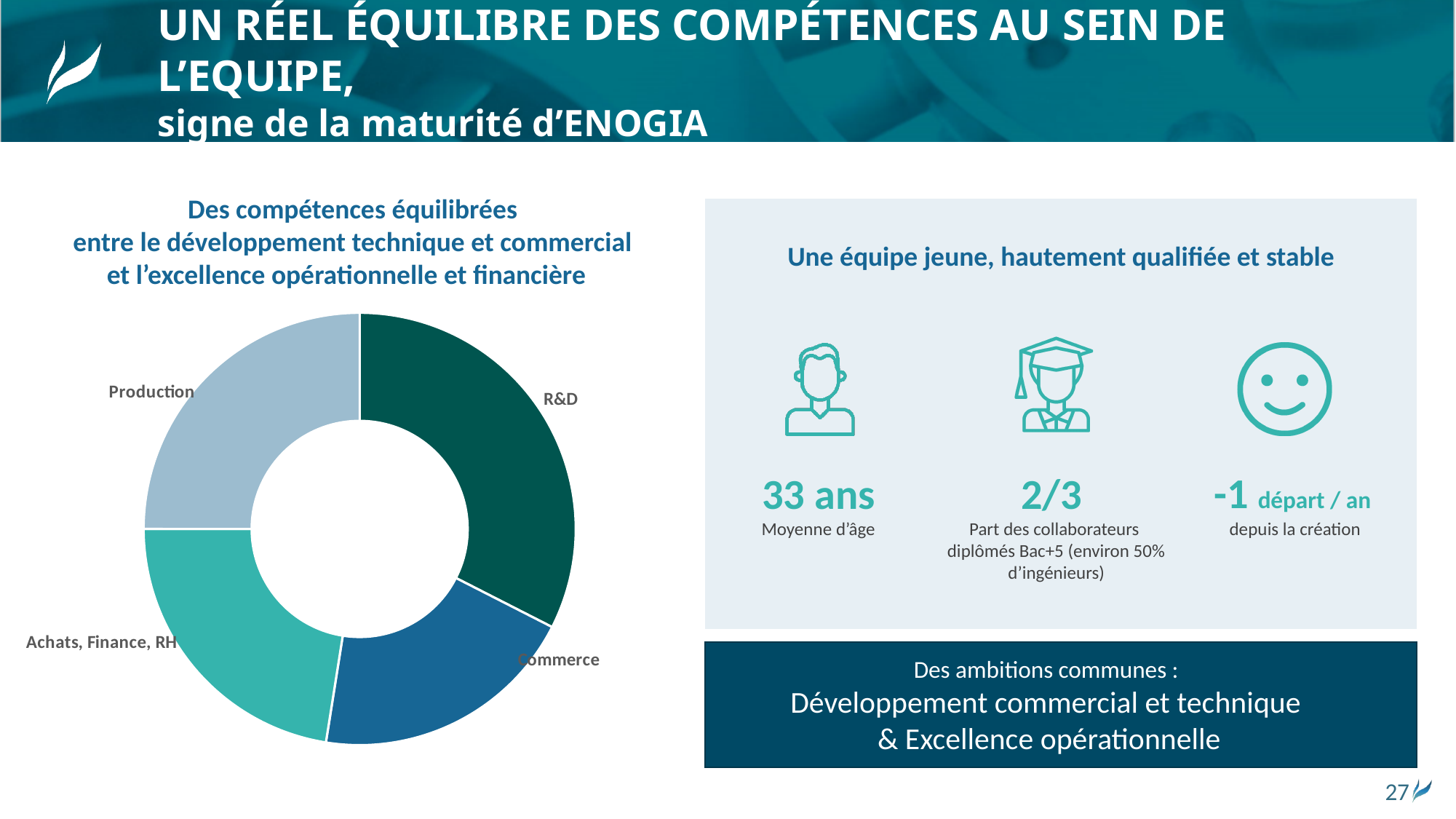
What is the title above the donut chart? Des compétences équilibrées entre le développement technique et commercial et l'excellence opérationnelle et financière Which category has the smallest slice in the donut chart? Commerce In the donut chart, which slice is larger: Achats, Finance, RH or Commerce? Achats, Finance, RH How many categories does the donut chart on the left show? 4 In the donut chart, which slice is larger: R&D or Commerce? R&D What kind of chart is shown on the left of the slide? donut (pie) chart Which category in the donut chart is shown in dark green? R&D Which category has the largest slice in the donut chart? R&D In the donut chart, which slice is larger: Production or Commerce? Production